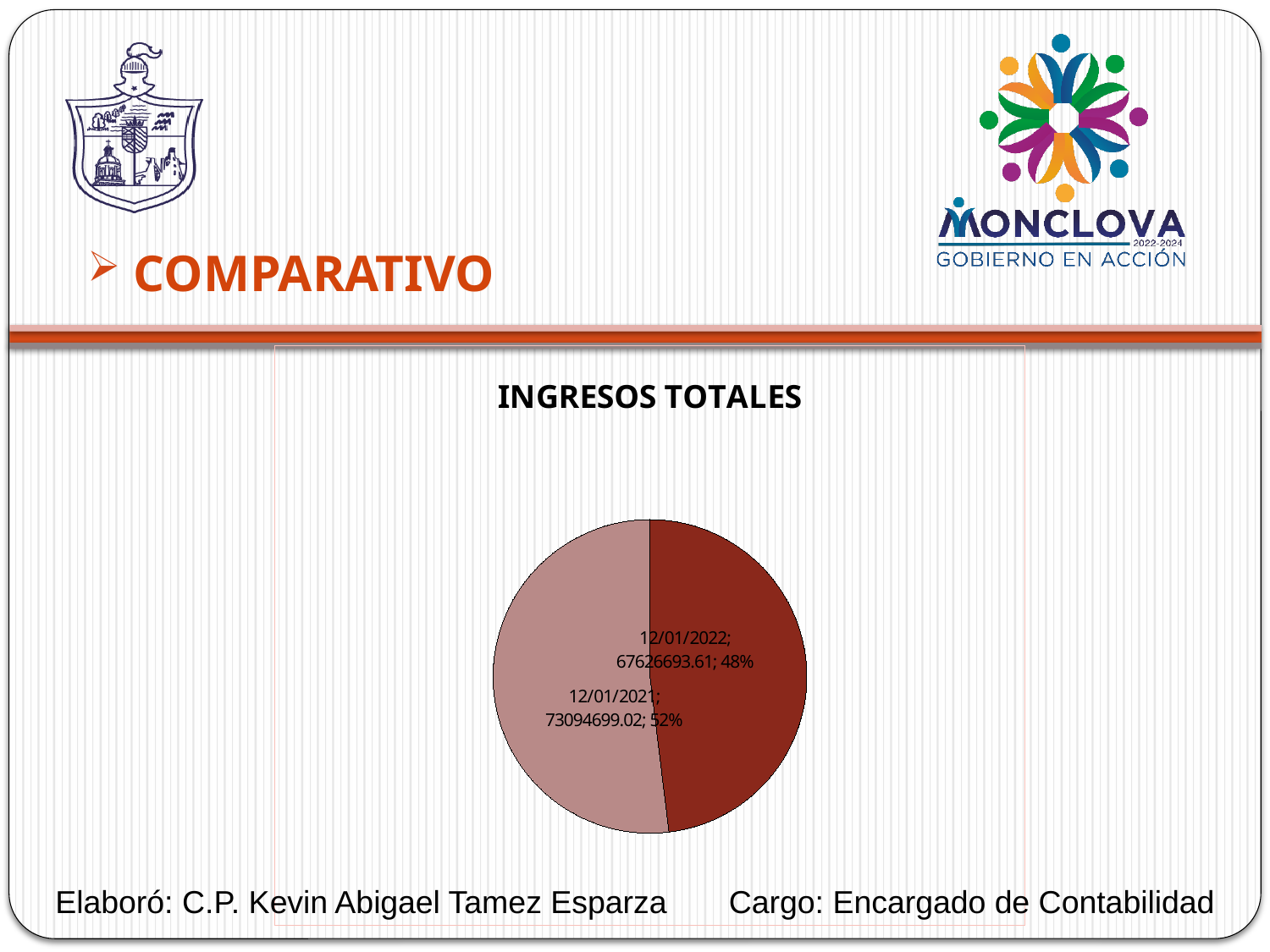
How many slices does the pie chart have? 2 What kind of chart is shown on the slide? pie chart What is the title of the chart? INGRESOS TOTALES What share of the pie does 12/01/2021 represent? 52% Which slice is the smallest in the pie chart? 12/01/2022 What colour is the 12/01/2022 slice in the pie chart? dark red Which is larger, the value for 12/01/2021 or for 12/01/2022? 12/01/2021 What is the value for 12/01/2022 in the pie chart? 67626693.61 What is the value for 12/01/2021 in the pie chart? 73094699.02 What share of the pie does 12/01/2022 represent? 48% What is the difference between the values for 12/01/2021 and 12/01/2022? 5468005.41 Which slice is the largest in the pie chart? 12/01/2021